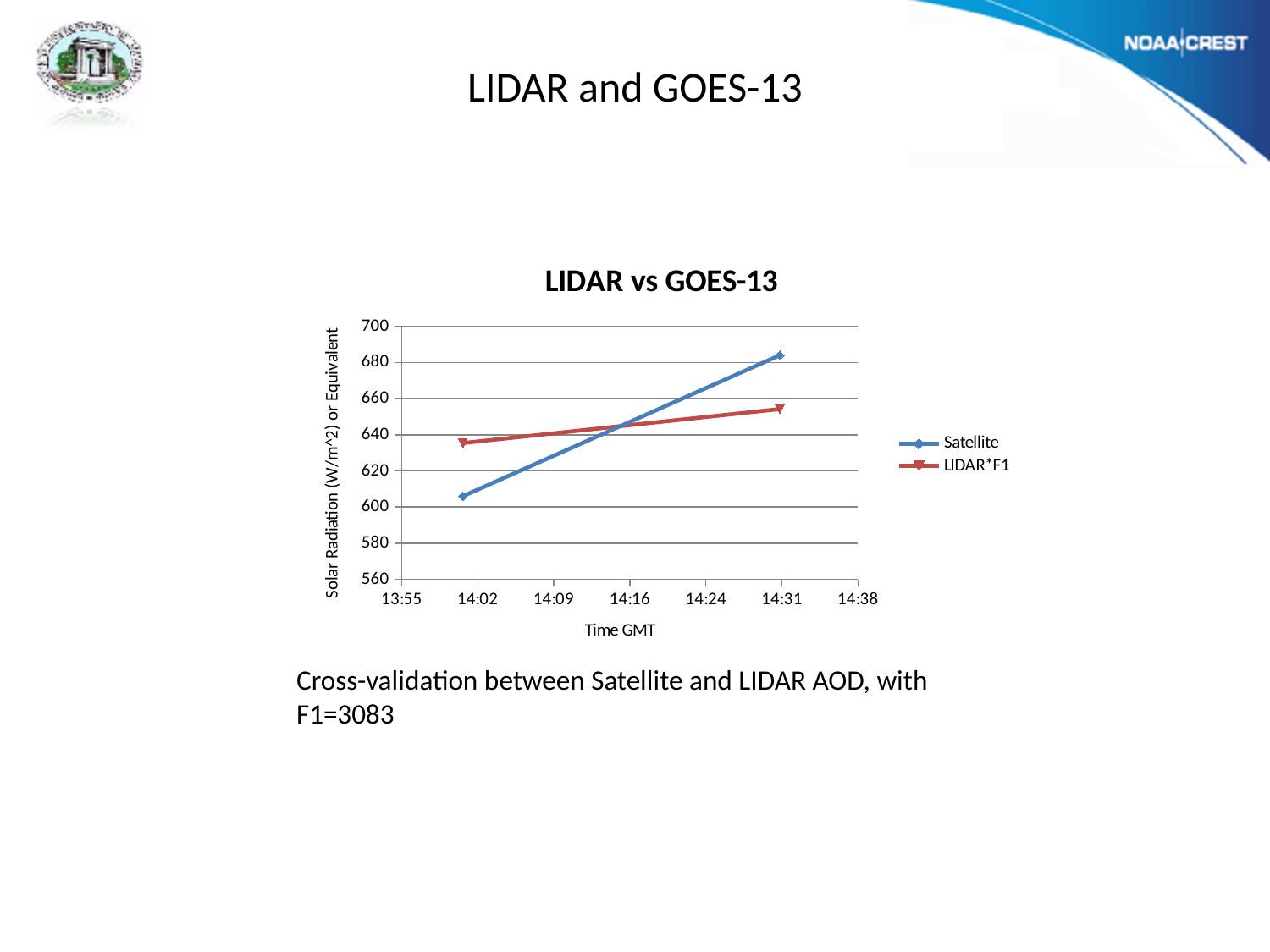
At the first time point, which series has the higher value, Satellite or LIDAR*F1? LIDAR*F1 What is the title of the chart? LIDAR vs GOES-13 What kind of chart is shown on the slide? line chart At the last time point, which series has the higher value, Satellite or LIDAR*F1? Satellite Is the last LIDAR*F1 value greater or less than 660? less How many data points does the Satellite series have? 2 Does the Satellite series rise or fall over time? rise Is the first LIDAR*F1 value greater or less than 620? greater How many series does the legend list? 2 Is the first Satellite value greater or less than 620? less Does the LIDAR*F1 series rise or fall over time? rise